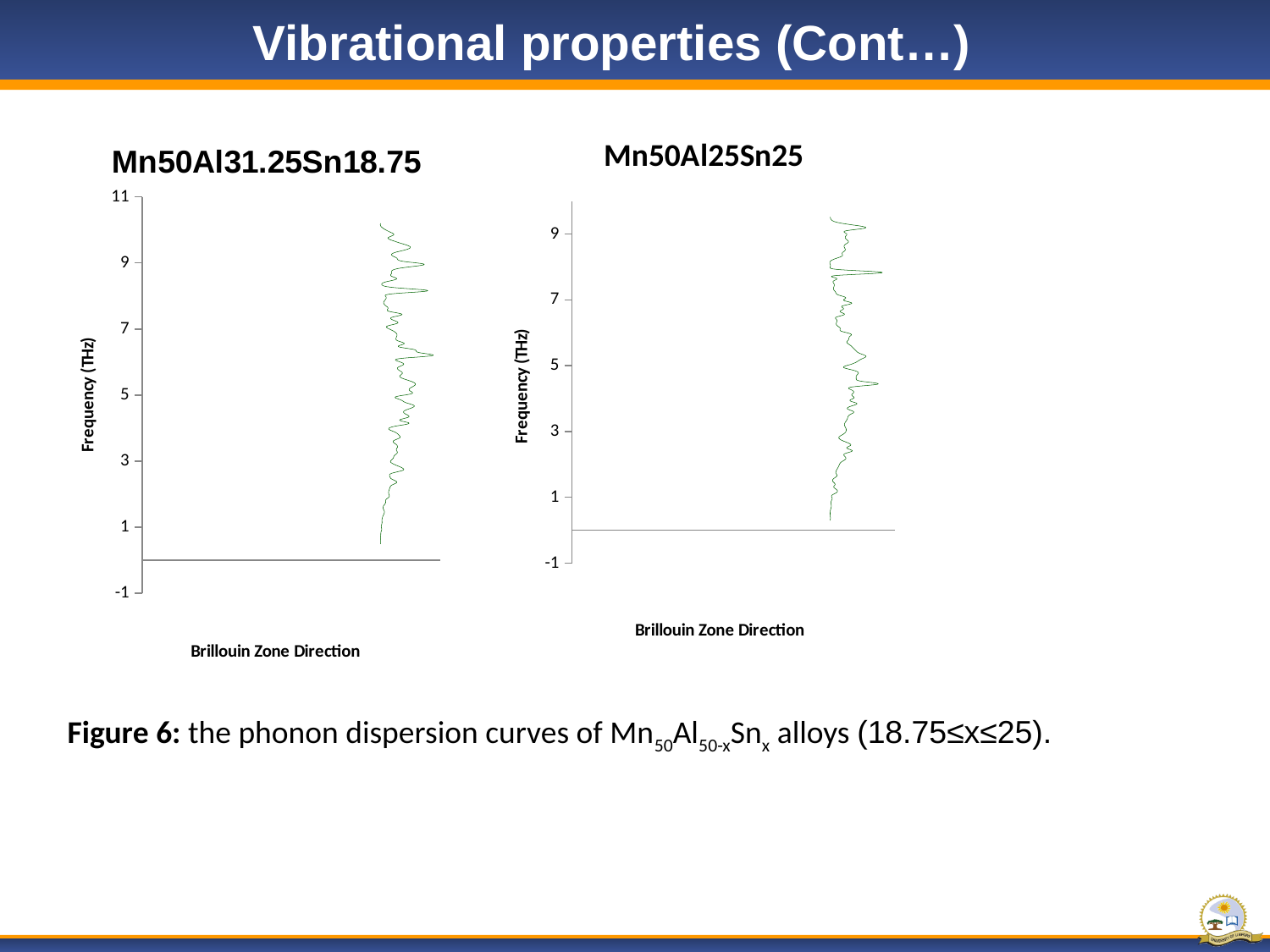
In the chart titled Mn50Al25Sn25, is the lowest frequency reached by the curve greater or less than 1? less In the chart titled Mn50Al31.25Sn18.75, is the highest frequency reached by the curve greater or less than 11? less In the chart titled Mn50Al31.25Sn18.75, is the lowest frequency reached by the curve greater or less than 1? less How many charts are shown on the slide? 2 What kind of chart is the one titled Mn50Al31.25Sn18.75? line chart In the chart titled Mn50Al31.25Sn18.75, what is the label of the vertical axis? Frequency (THz) What is the highest tick value shown on the vertical axis of the chart titled Mn50Al31.25Sn18.75? 11 What kind of chart is the one titled Mn50Al25Sn25? line chart In the chart titled Mn50Al25Sn25, what is the label of the horizontal axis? Brillouin Zone Direction